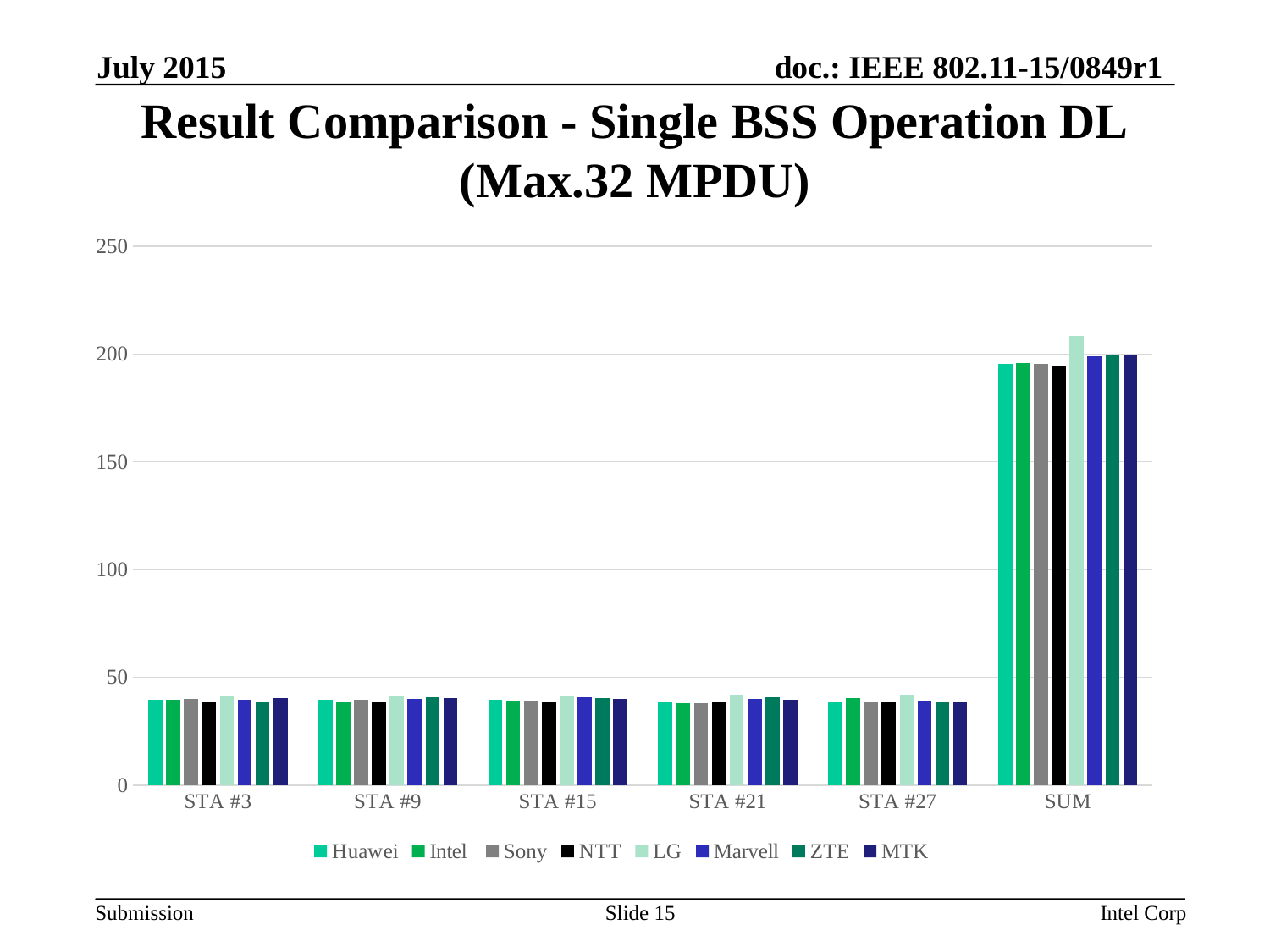
How many categories are shown along the x axis? 6 Which series has the highest value for the SUM category? LG How many series does the legend list? 8 Is the NTT value for SUM greater or less than 200? less Which series is listed first in the legend? Huawei Which is larger in the SUM category: the LG value or the NTT value? LG Is the LG value for SUM greater or less than 200? greater Which is larger for the LG series: the value for SUM or the value for STA #27? SUM What kind of chart is shown on the slide? bar chart What is the title of the chart on the slide? Result Comparison - Single BSS Operation DL (Max.32 MPDU) Is the Huawei value for STA #3 greater or less than 50? less